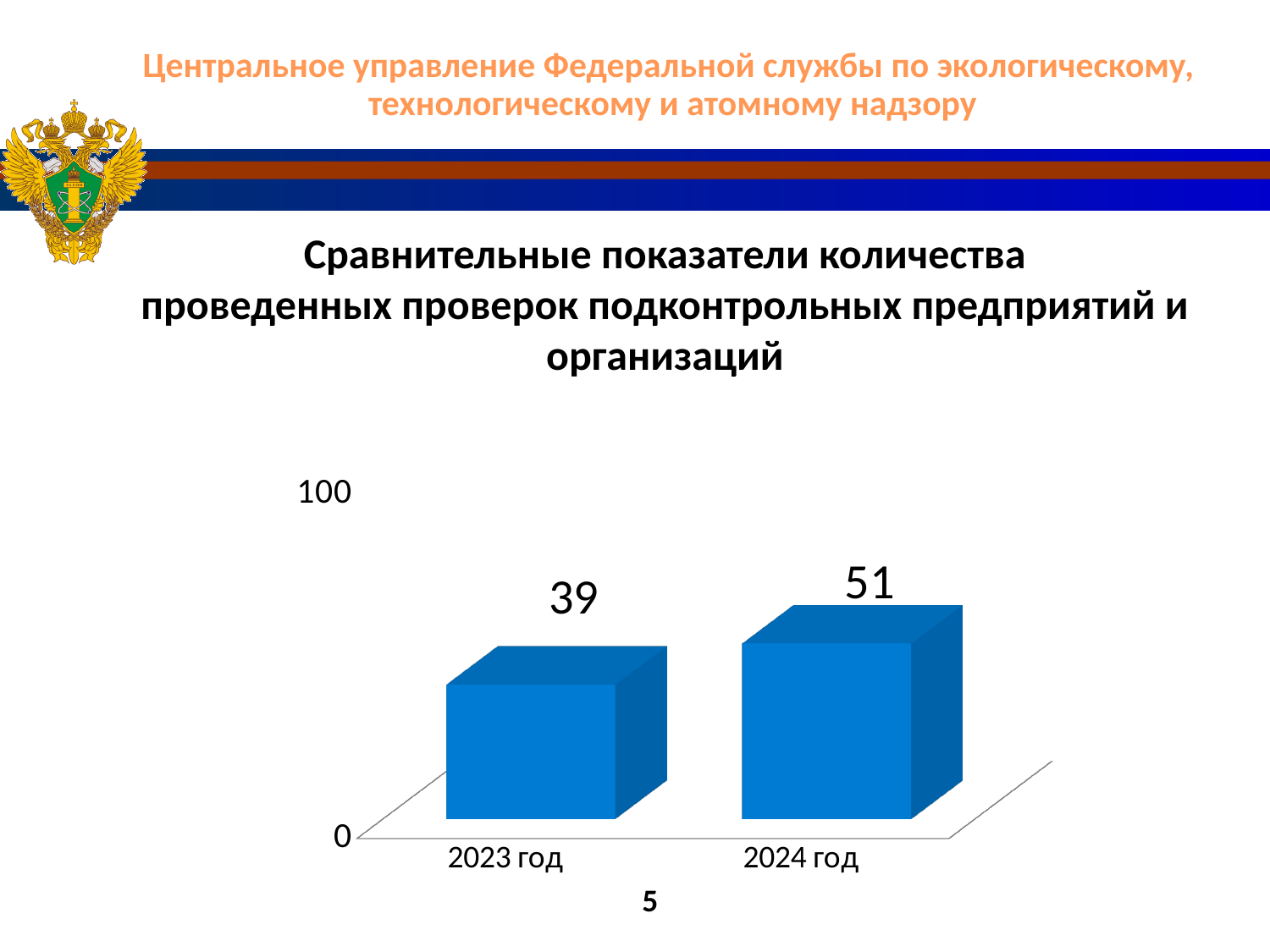
Do the values rise or fall from 2023 год to 2024 год? rise What is the value for 2024 год? 51 Which year has the highest value? 2024 год What kind of chart is shown on the slide? bar chart What colour are the bars in the chart? blue Is the value for 2024 год greater or less than 100? less Which year has the lowest value? 2023 год What is the value for 2023 год? 39 What is the difference between the values for 2024 год and 2023 год? 12 Which is larger, the value for 2023 год or the value for 2024 год? 2024 год How many categories are shown on the x axis? 2 What is the title of the chart? Сравнительные показатели количества проведенных проверок подконтрольных предприятий и организаций